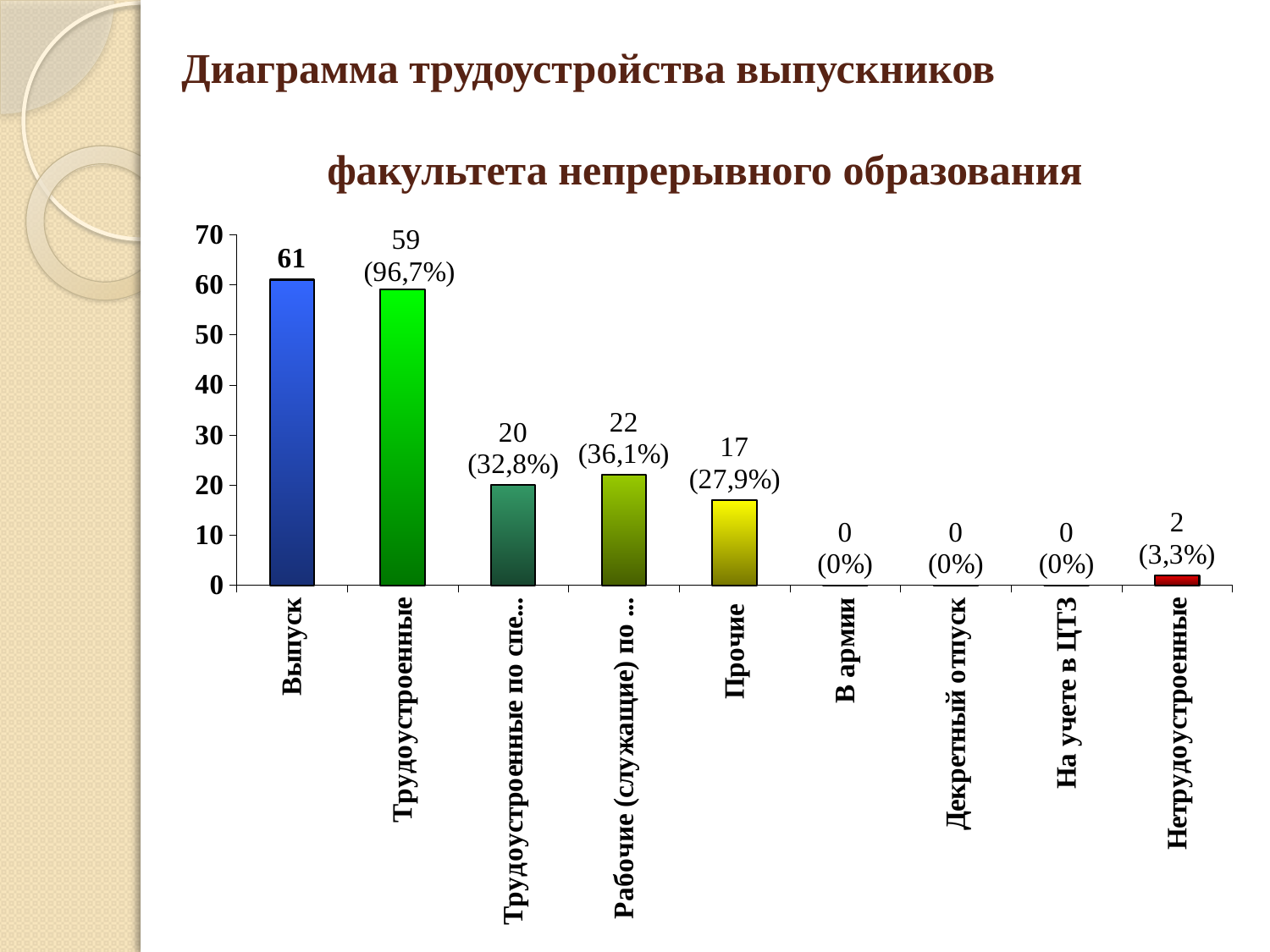
What is the value for Трудоустроенные? 59 What kind of chart is shown on the slide? Bar chart Which is larger, the value for Прочие or the value for Нетрудоустроенные? Прочие What percentage is shown for Нетрудоустроенные? 3,3% What is the value for Выпуск? 61 Which category has the highest value? Выпуск What is the value for Нетрудоустроенные? 2 What is the value for Декретный отпуск? 0 What is the value for Прочие? 17 What percentage is shown for Трудоустроенные? 96,7% What is the difference between the values for Выпуск and Трудоустроенные? 2 How many categories are shown on the x axis? 9